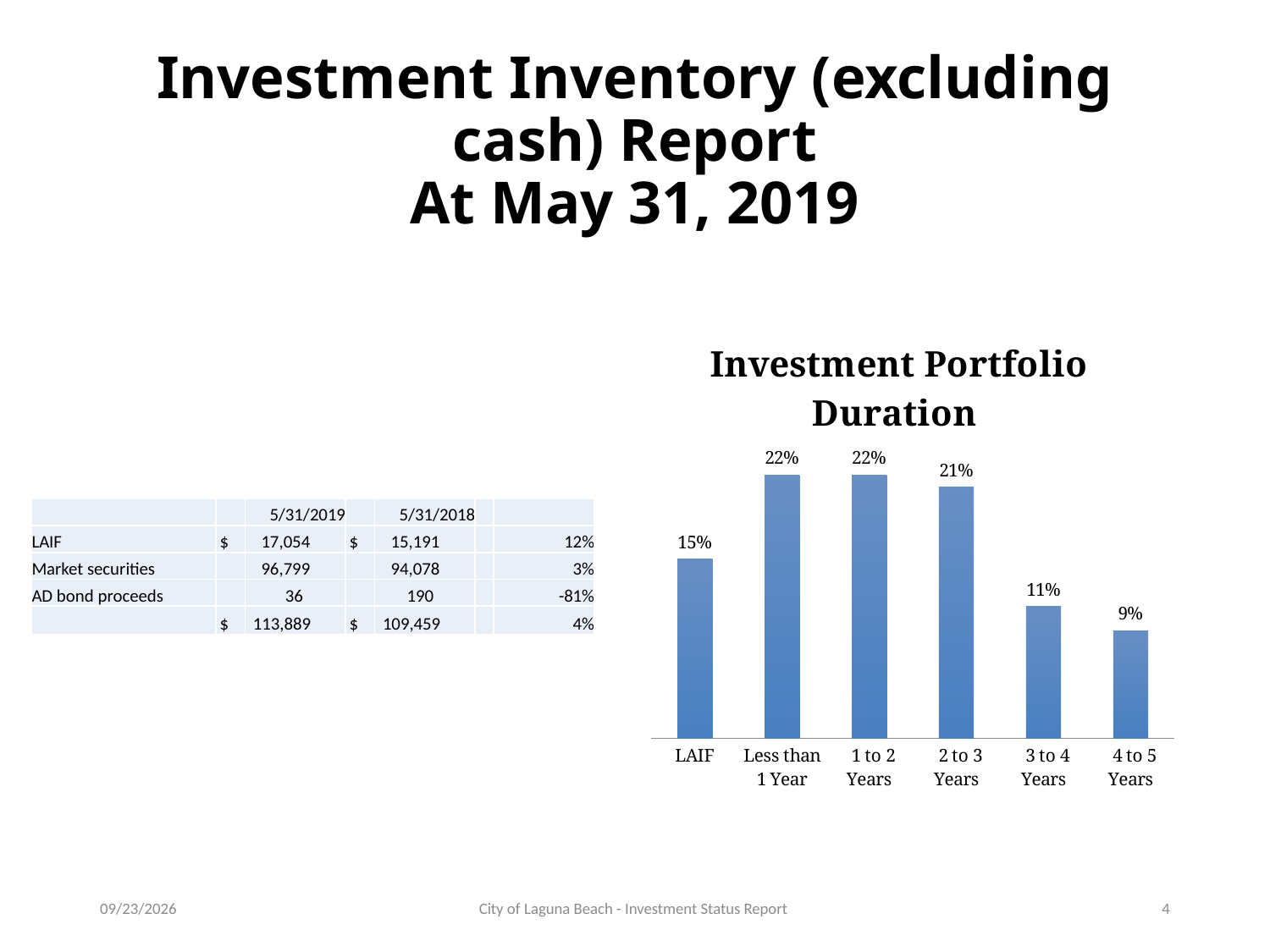
Which is larger in the Investment Portfolio Duration chart, the value for 2 to 3 Years or the value for 4 to 5 Years? 2 to 3 Years What is the difference between the values for LAIF and 4 to 5 Years in the Investment Portfolio Duration chart? 6% How many categories are shown in the Investment Portfolio Duration chart? 6 What is the difference between the values for 2 to 3 Years and 3 to 4 Years in the Investment Portfolio Duration chart? 10% What is the value for 2 to 3 Years in the Investment Portfolio Duration chart? 21% Which category has the lowest value in the Investment Portfolio Duration chart? 4 to 5 Years Which is larger in the Investment Portfolio Duration chart, the value for LAIF or the value for 3 to 4 Years? LAIF What is the value for 4 to 5 Years in the Investment Portfolio Duration chart? 9% What is the title of the chart on the slide? Investment Portfolio Duration What kind of chart is the Investment Portfolio Duration chart? Bar chart What is the value for 3 to 4 Years in the Investment Portfolio Duration chart? 11% What is the value for LAIF in the Investment Portfolio Duration chart? 15%